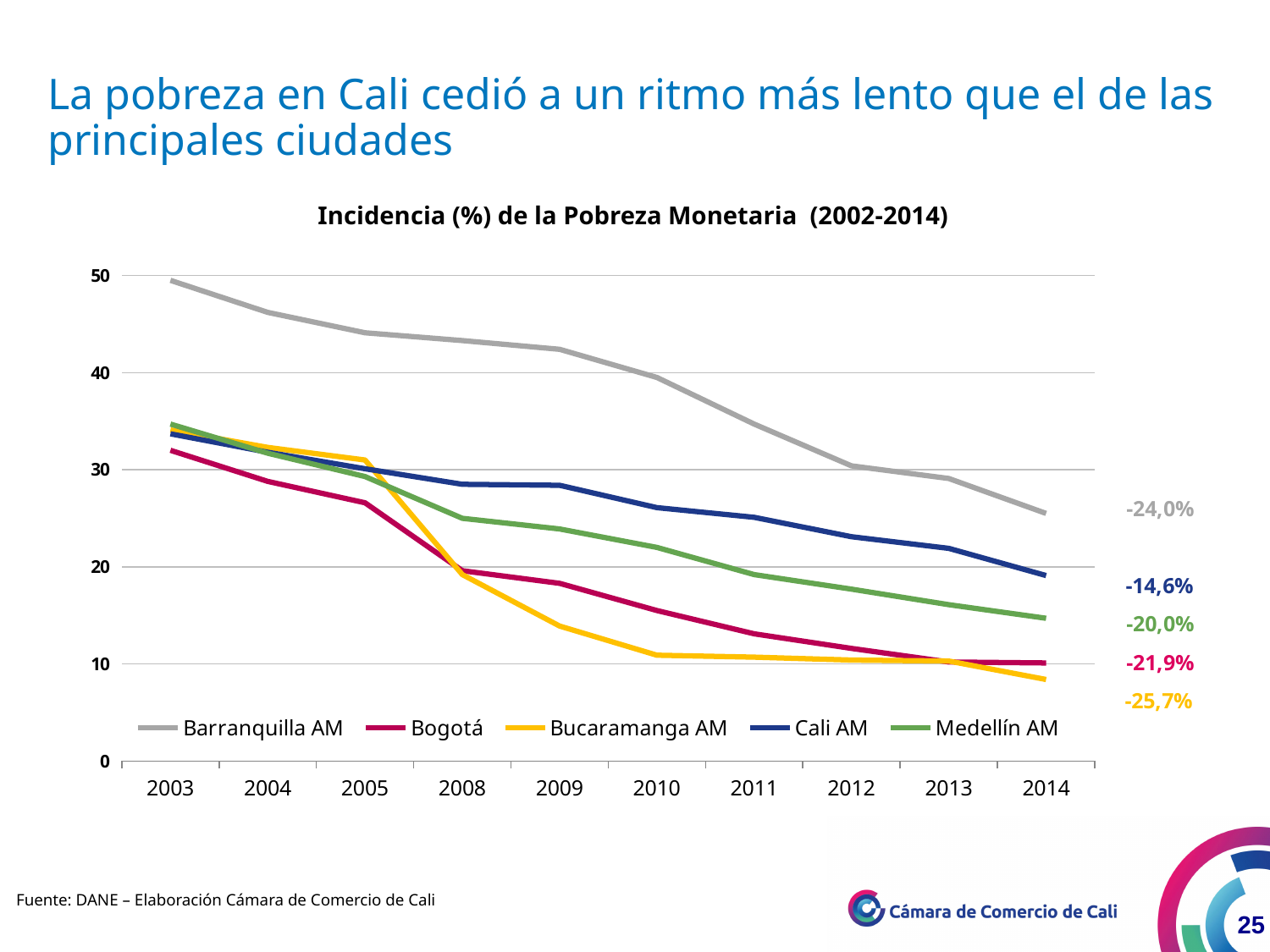
Is the value for Barranquilla AM in 2003 greater or less than 40? greater What kind of chart is shown on the slide? line chart What is the title of the chart? Incidencia (%) de la Pobreza Monetaria (2002-2014) Is the value for Medellín AM in 2014 greater or less than 20? less What percentage change is annotated next to the Cali AM line at the right of the chart? -14,6% Is the value for Bogotá in 2014 greater or less than 20? less Which series has the highest value in 2003? Barranquilla AM How many years are shown on the x axis? 10 How many series does the legend list? 5 Does the Barranquilla AM line rise or fall from 2003 to 2014? fall In 2010, which is higher: Cali AM or Medellín AM? Cali AM Which series has the lowest value in 2014? Bucaramanga AM